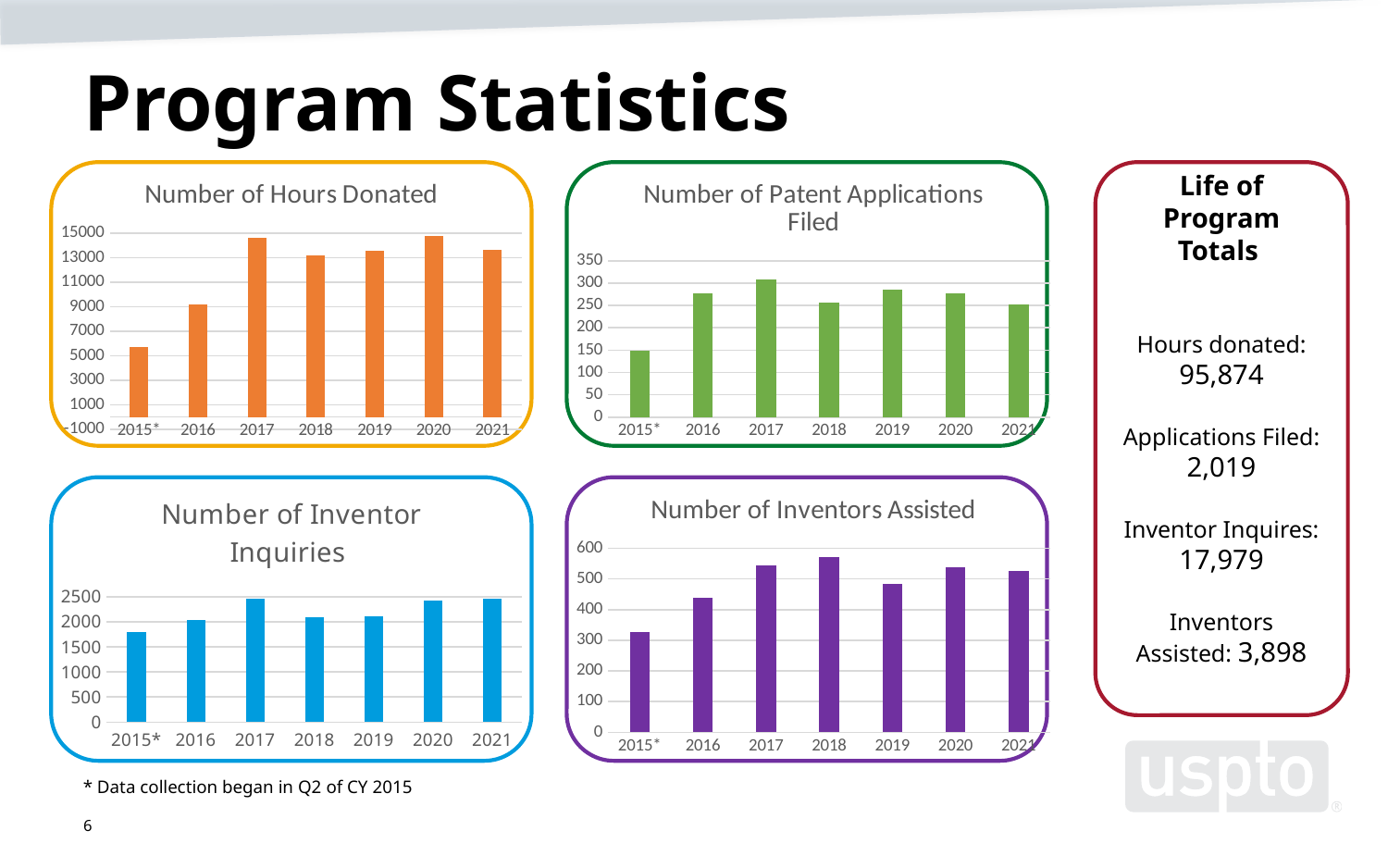
In the Number of Patent Applications Filed chart, how many years are shown on the x axis? 7 In the Number of Patent Applications Filed chart, is the value for 2015* greater or less than 200? less In the Number of Hours Donated chart, is the value for 2015* greater or less than 7000? less In the Number of Inventor Inquiries chart, is the value for 2017 greater or less than 2000? greater In the Number of Inventor Inquiries chart, which year has the lowest value? 2015* In the Number of Hours Donated chart, which year has the lowest value? 2015* In the Number of Patent Applications Filed chart, which year has the highest value? 2017 What kind of chart is the Number of Inventors Assisted chart? bar chart In the Number of Inventors Assisted chart, which year has the highest value? 2018 In the Number of Hours Donated chart, which is larger, the value for 2016 or the value for 2017? 2017